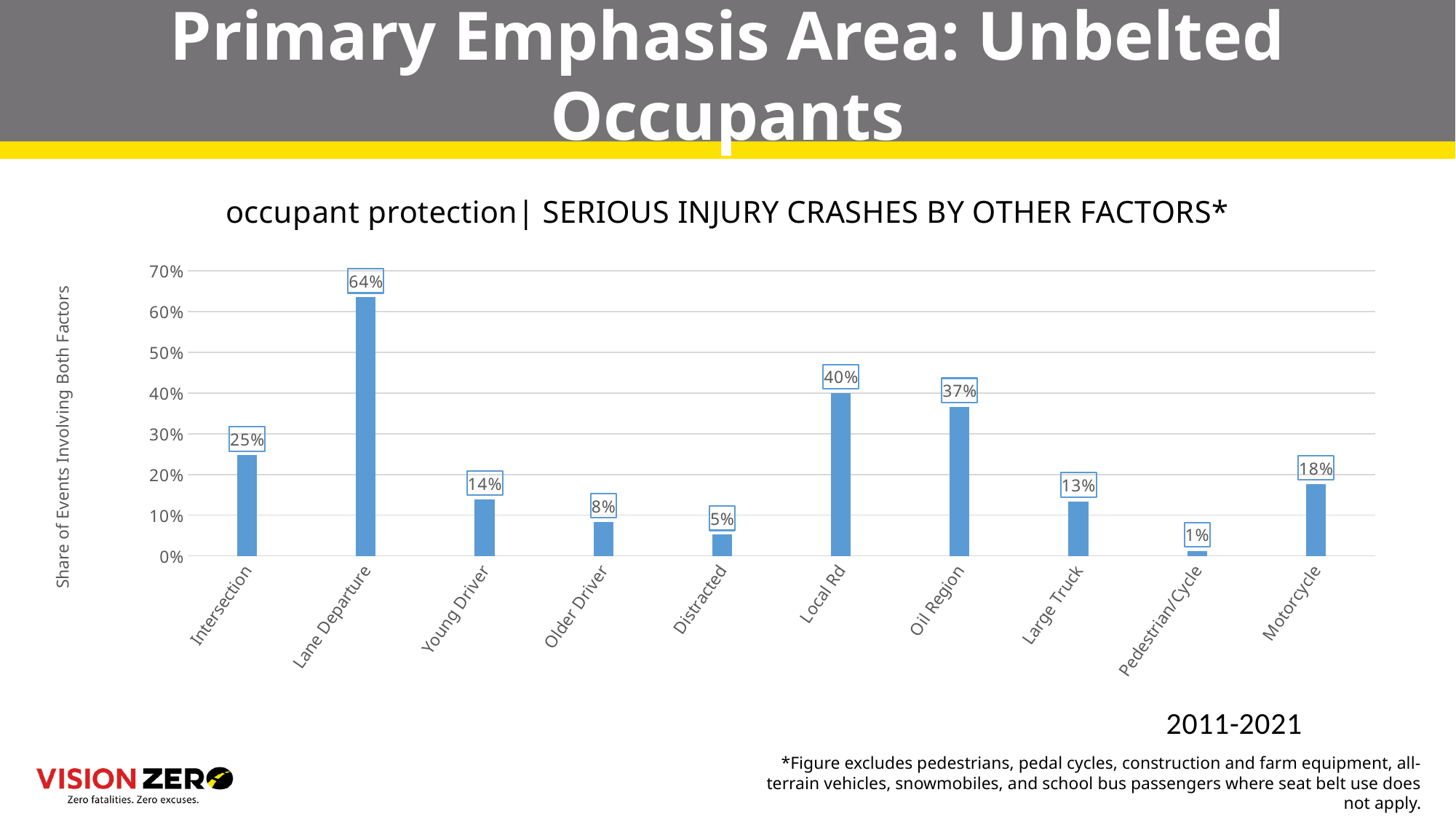
Which is larger, the value for Intersection or the value for Motorcycle? Intersection How many categories are shown on the x axis? 10 What is the value for Lane Departure? 64% What is the value for Oil Region? 37% What is the label of the y axis? Share of Events Involving Both Factors Is the value for Local Rd greater or less than 30%? greater Which category has the highest value? Lane Departure What kind of chart is shown? Bar chart What is the difference between the values for Local Rd and Oil Region? 3% Which category has the lowest value? Pedestrian/Cycle What is the value for Pedestrian/Cycle? 1% What time period is shown below the chart? 2011-2021